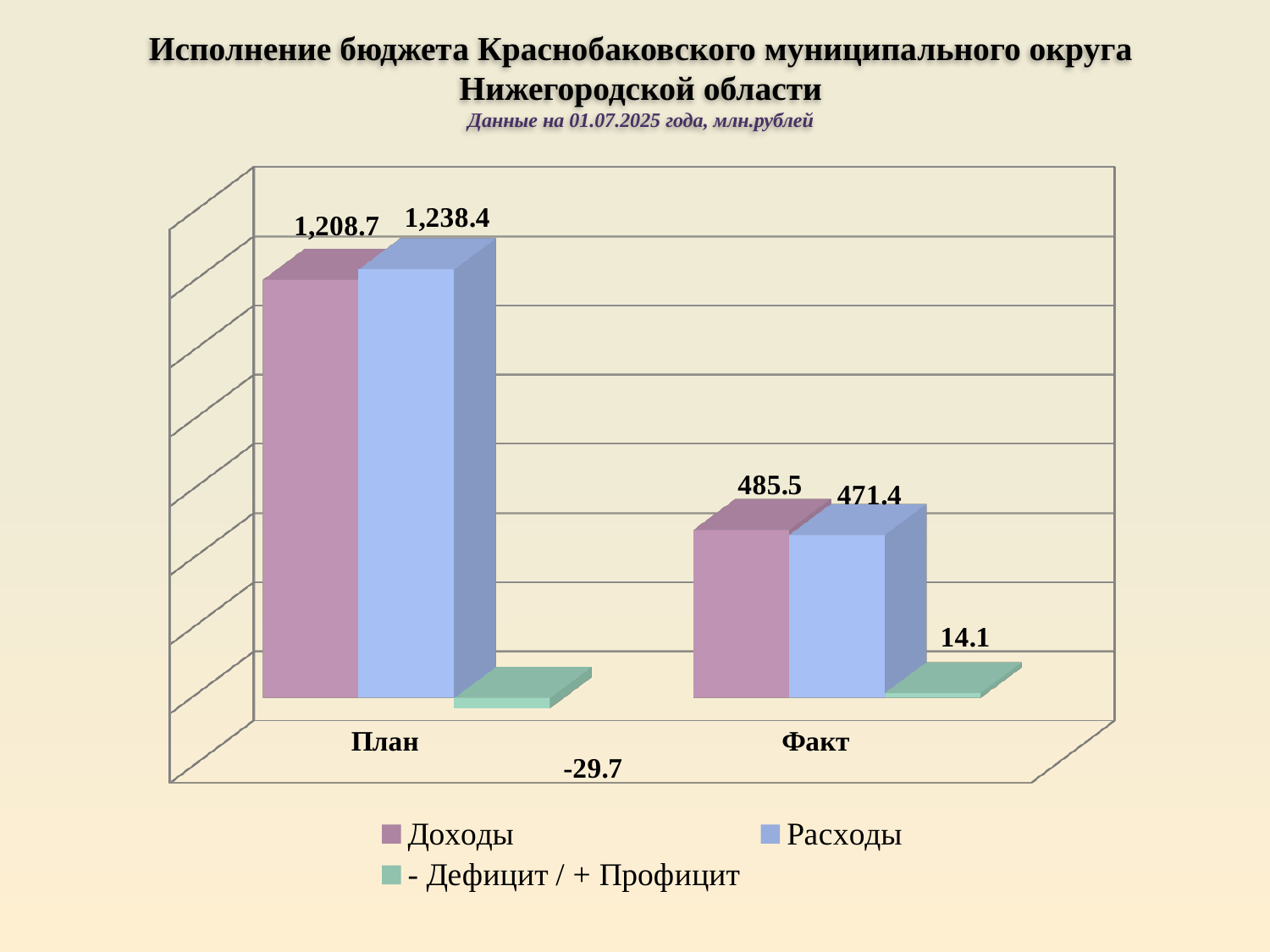
What is the value of the - Дефицит / + Профицит series for План? -29.7 What is the difference between Доходы for План and Доходы for Факт? 723.2 What is the value of the - Дефицит / + Профицит series for Факт? 14.1 What is the value of Расходы for Факт? 471.4 How many series does the legend list? 3 Which is larger for Факт: Доходы or Расходы? Доходы What is the value of Расходы for План? 1,238.4 How many categories are shown on the x axis? 2 What kind of chart is shown on the slide? Bar chart What is the value of Доходы for План? 1,208.7 What is the value of Доходы for Факт? 485.5 Which is larger for План: Доходы or Расходы? Расходы